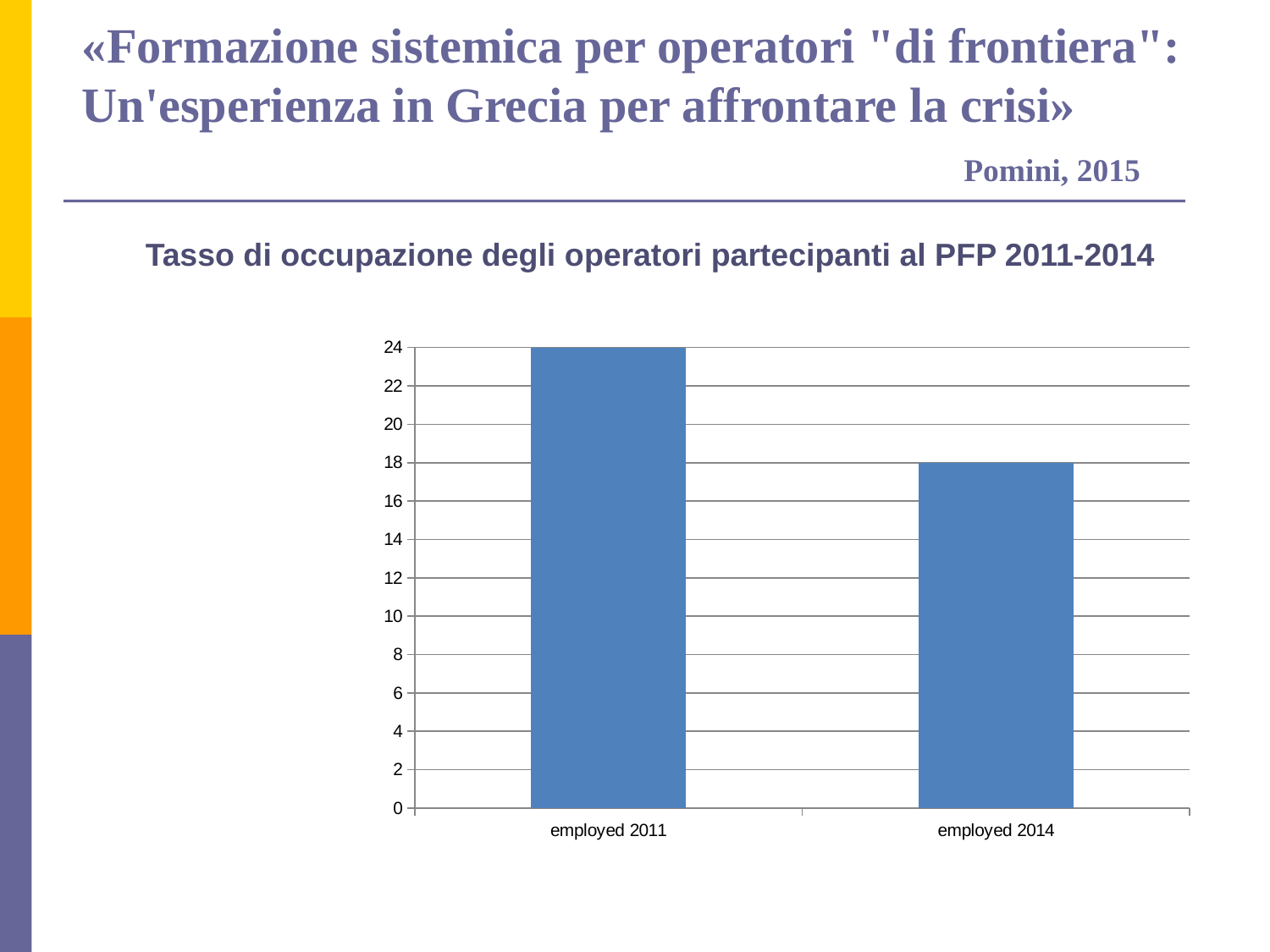
Is the value for employed 2014 greater or less than 20? less Is the value for employed 2011 greater or less than 20? greater What is the value for employed 2011? 24 What is the value for employed 2014? 18 What kind of chart is shown on the slide? bar chart Do the values rise or fall from employed 2011 to employed 2014? fall Which is larger, the value for employed 2011 or employed 2014? employed 2011 Which category has the lowest value? employed 2014 How many categories are shown on the x axis? 2 What is the title of the chart? Tasso di occupazione degli operatori partecipanti al PFP 2011-2014 Which category has the highest value? employed 2011 What is the difference between the values for employed 2011 and employed 2014? 6